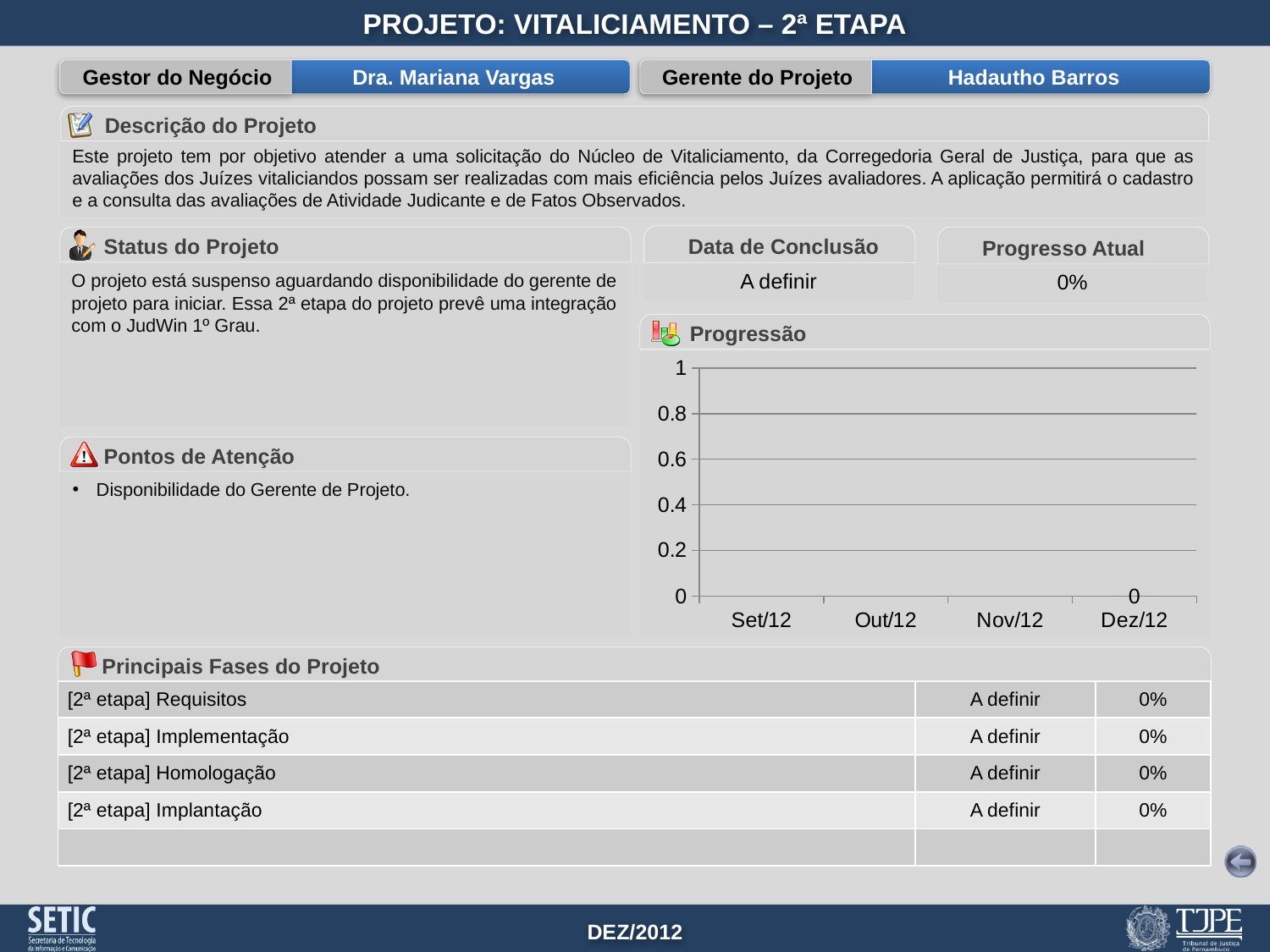
In the Progressão chart, what is the first category on the x axis? Set/12 In the Progressão chart, is the value for Dez/12 greater or less than 0.2? less In the Progressão chart, what is the highest value shown on the y axis? 1 In the Progressão chart, what is the last category on the x axis? Dez/12 In the Progressão chart, how many categories are shown on the x axis? 4 In the Progressão chart, what is the value labelled for Dez/12? 0